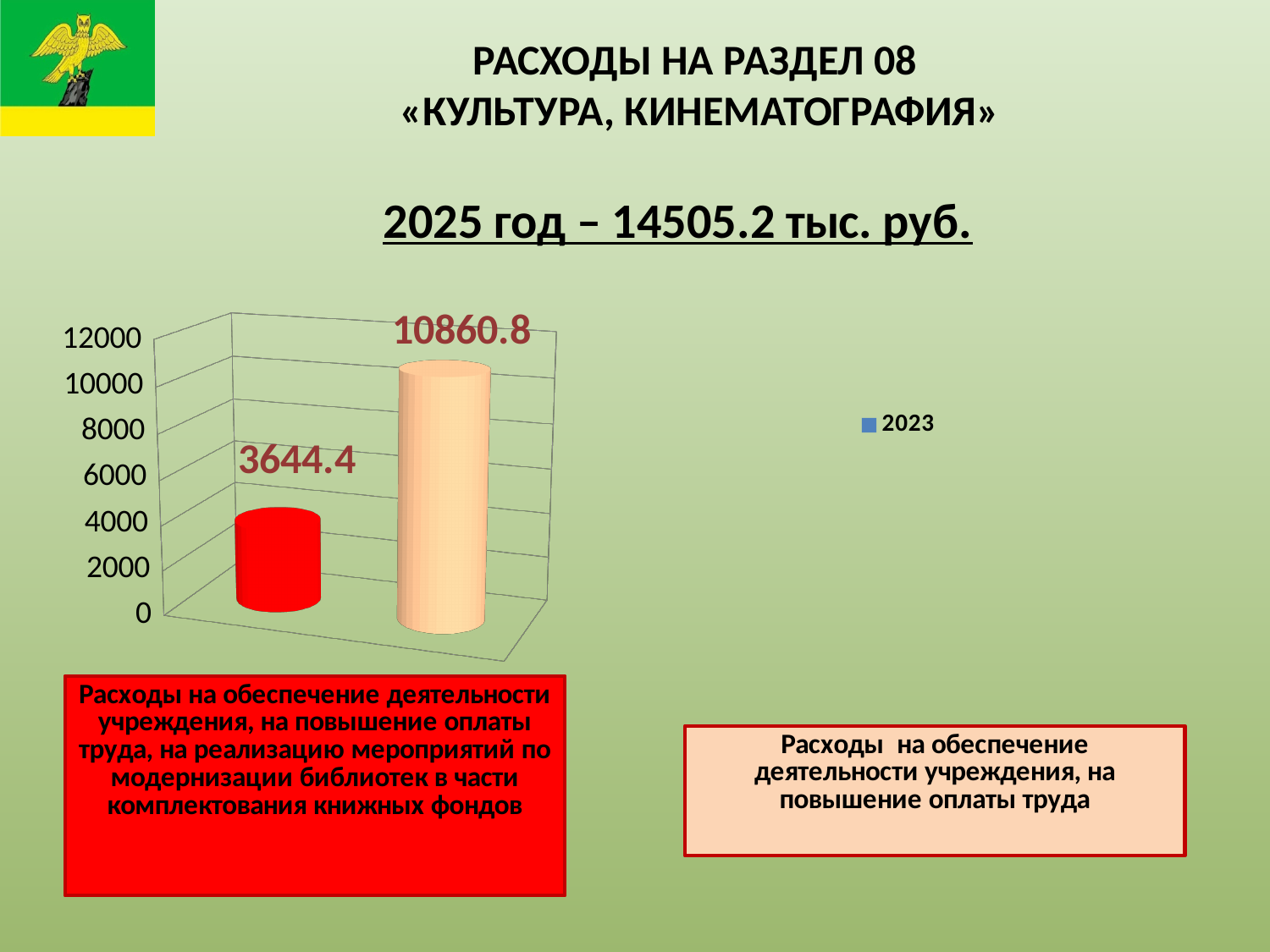
What is the value of the red bar (expenses on institution activities, wage increases and library modernisation for book fund acquisition)? 3644.4 What is the difference between the peach-coloured bar and the red bar? 7216.4 What is the series name shown in the chart legend? 2023 Is the value of the peach-coloured bar greater or less than 10000? greater How many series does the chart legend list? 1 Which bar has the lowest value? The red bar (3644.4) Is the value of the red bar larger or smaller than the value of the peach-coloured bar? Smaller Is the value of the red bar greater or less than 4000? less Which bar has the highest value, the red one or the peach-coloured one? The peach-coloured bar (10860.8) What is the value of the peach-coloured bar (expenses on institution activities and wage increases)? 10860.8 What type of chart is shown on the slide? Bar chart How many bars are plotted in the chart? 2